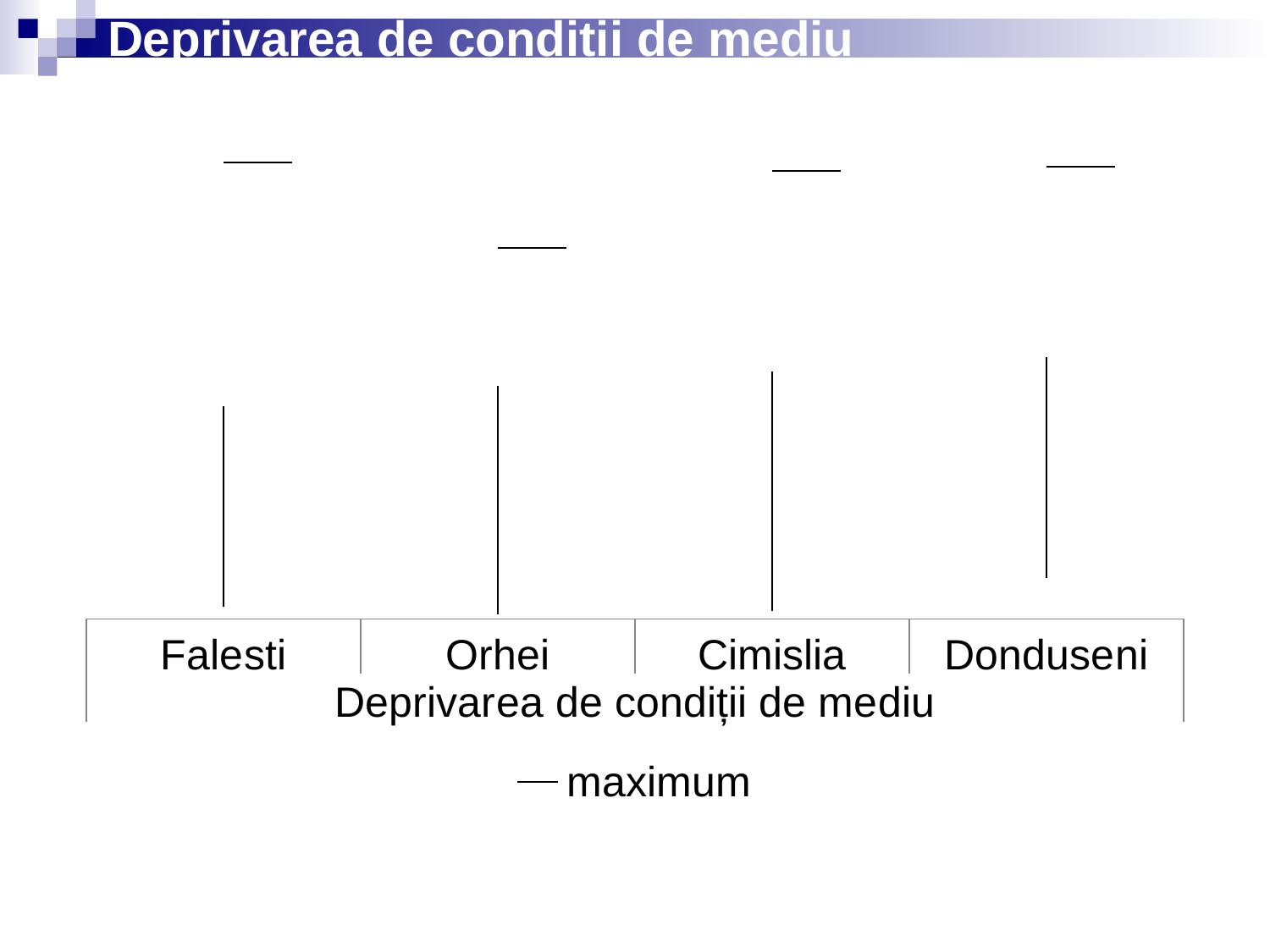
How many series does the chart legend list? 1 What is the title shown under the category labels on the x axis? Deprivarea de condiții de mediu Which category has the lowest 'maximum' marker in the chart? Orhei Which has the higher 'maximum' marker, Orhei or Donduseni? Donduseni How many categories are shown on the x axis of the chart? 4 What is the name of the series listed in the chart legend? maximum Which category is listed first on the x axis of the chart? Falesti Which has the higher 'maximum' marker, Orhei or Cimislia? Cimislia Which has the higher 'maximum' marker, Falesti or Orhei? Falesti